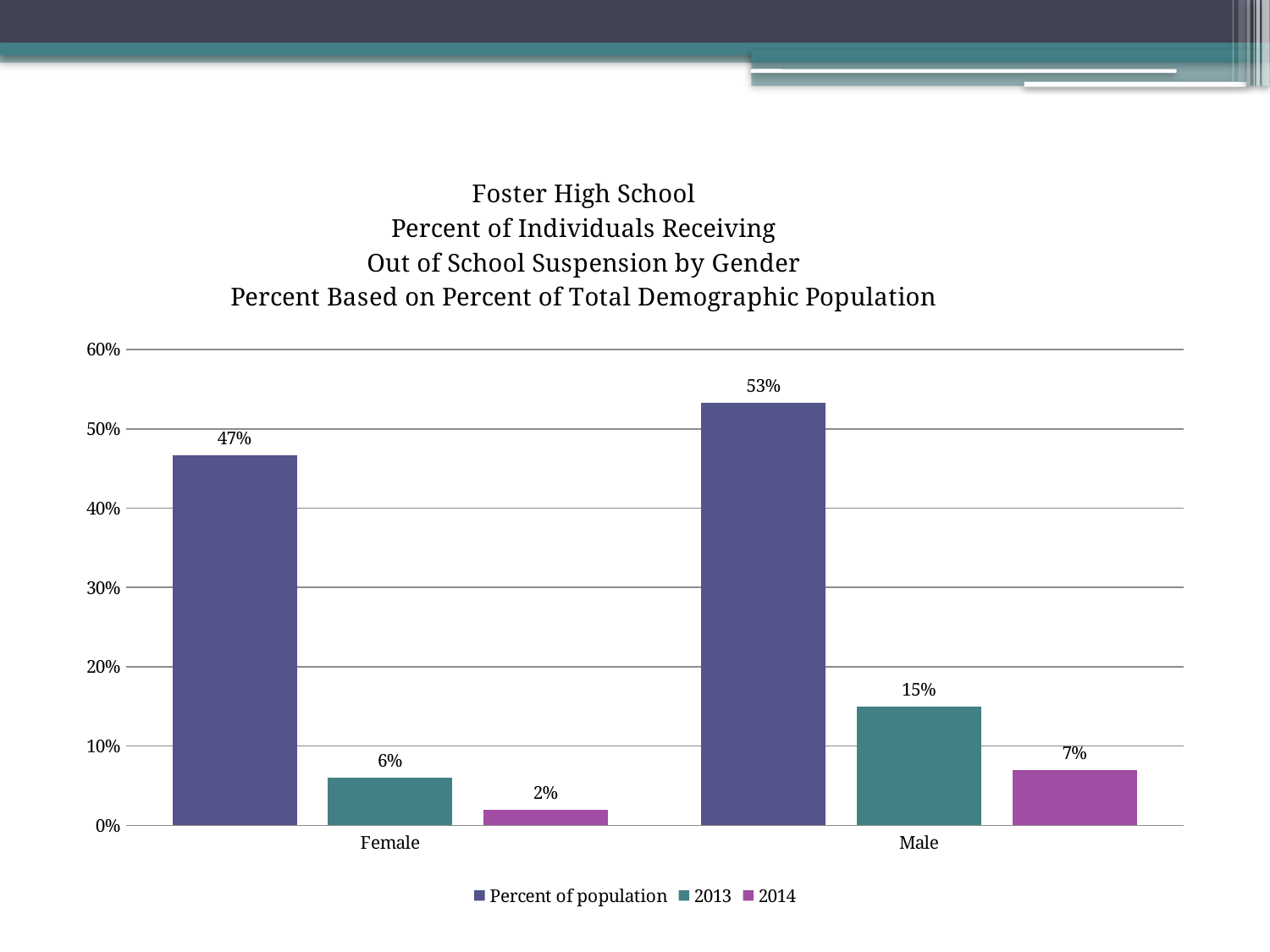
Which gender has the higher Percent of population value? Male What is the 2014 value for Female? 2% Is the Percent of population value for Male greater or less than 50%? greater How many categories are shown on the x axis? 2 Which gender has the lowest 2014 value? Female Which is larger: the 2013 value for Female or the 2014 value for Male? 2014 value for Male What is the 2014 value for Male? 7% What is the difference between the 2013 values for Male and Female? 9% How many series does the legend list? 3 What is the Percent of population value for Female? 47% What is the 2013 value for Male? 15% What kind of chart is shown on the slide? Bar chart